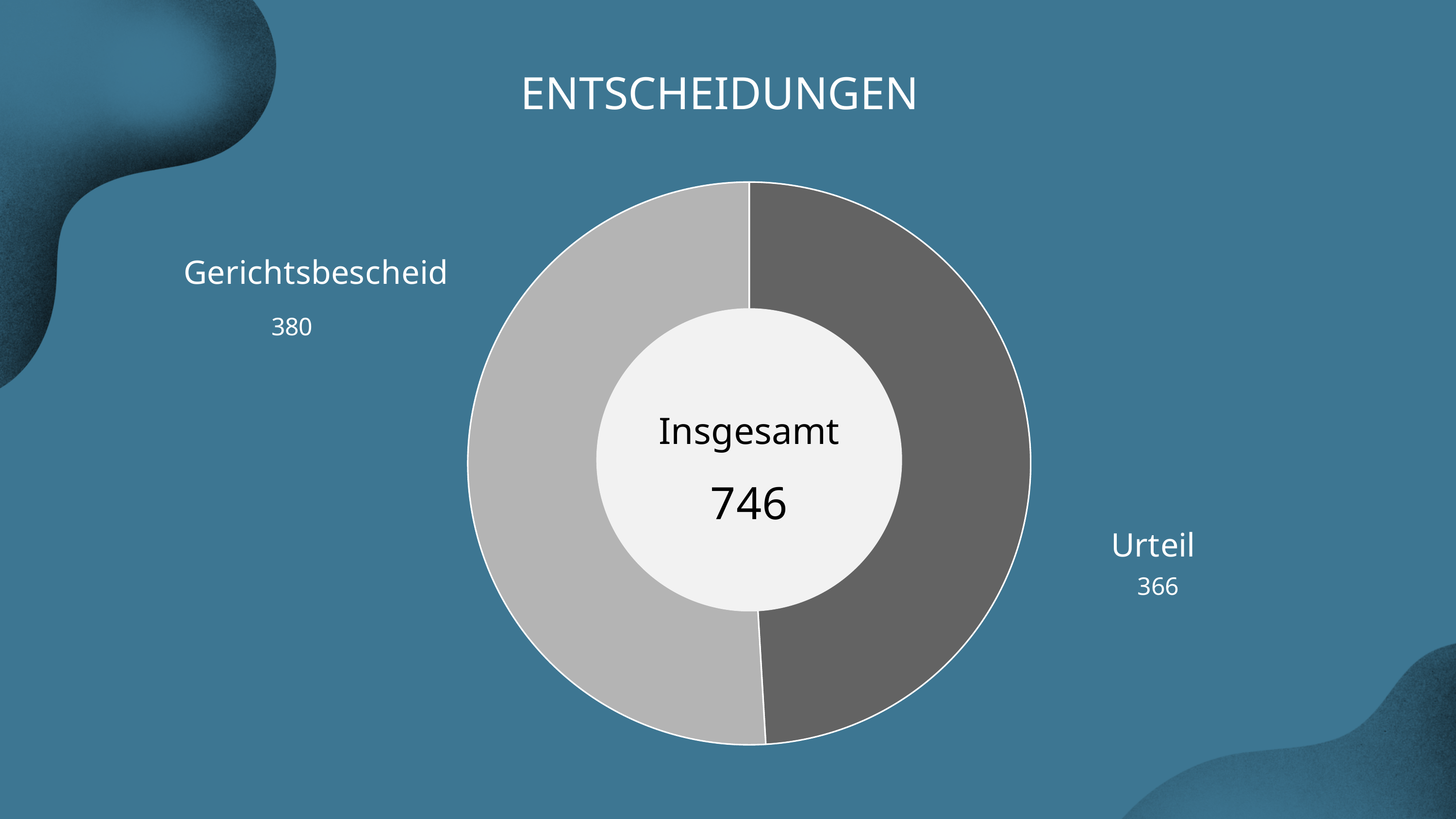
What kind of chart is shown on the slide? Doughnut chart What is the value for Gerichtsbescheid? 380 Which category has the lowest value? Urteil What total is shown in the centre of the chart? 746 What is the title of the chart? ENTSCHEIDUNGEN How many categories does the chart show? 2 What is the value for Urteil? 366 What is the difference between the values for Gerichtsbescheid and Urteil? 14 Which category has the highest value? Gerichtsbescheid What label appears in the centre of the doughnut above the total? Insgesamt Which is larger, the value for Gerichtsbescheid or the value for Urteil? Gerichtsbescheid